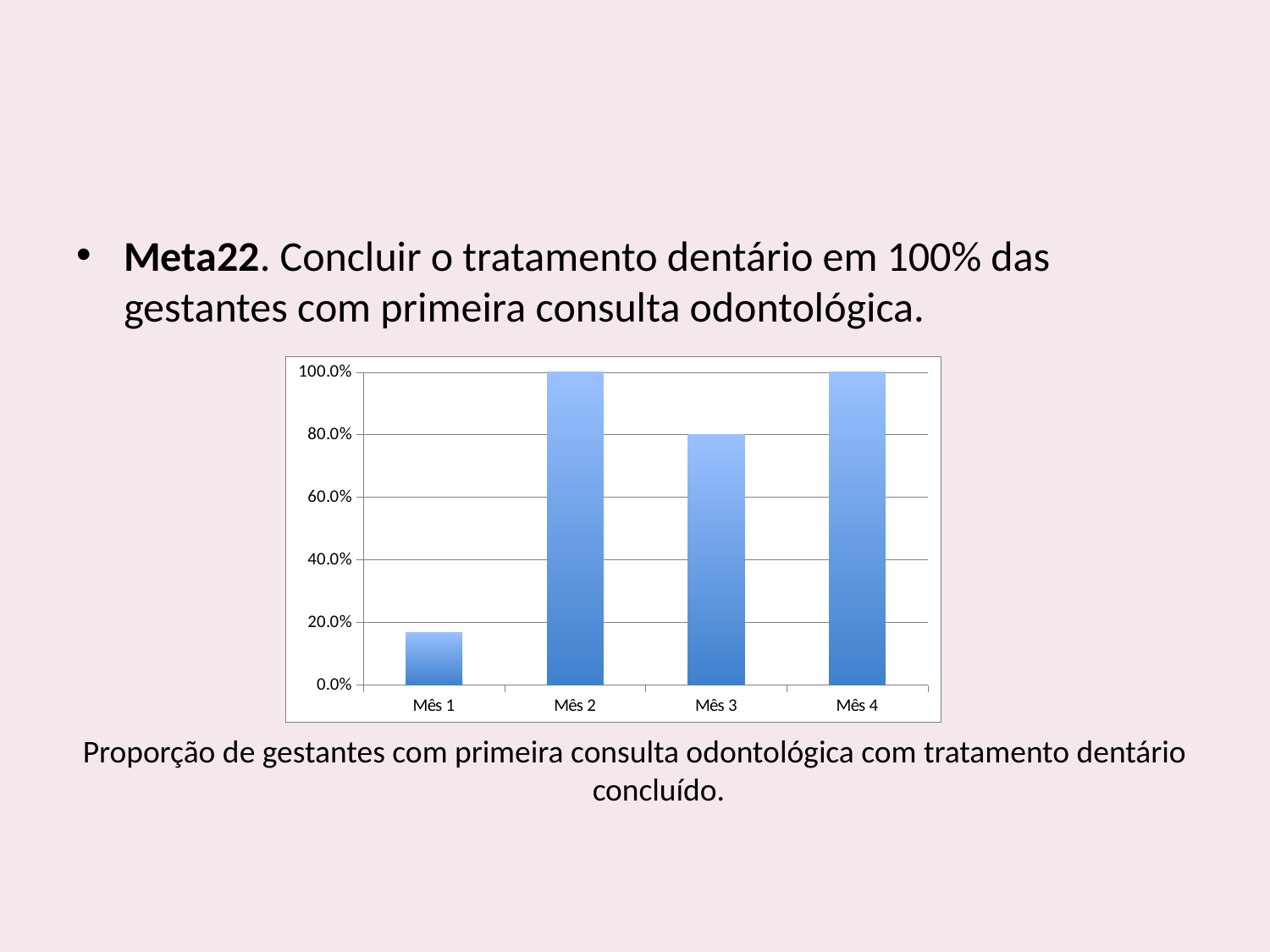
Does the value rise or fall from Mês 1 to Mês 2? Rise What is the value for Mês 2 in the chart? 100.0% What is the value for Mês 3 in the chart? 80.0% Is the value for Mês 1 greater or less than 20.0%? less Which month has the lowest value in the chart? Mês 1 How many categories (months) are shown on the x axis of the chart? 4 What kind of chart is shown on the slide? Bar chart What is the value for Mês 4 in the chart? 100.0% Which is larger, the value for Mês 1 or the value for Mês 3? Mês 3 What is the difference between the values for Mês 2 and Mês 3? 20.0% Is the value for Mês 3 greater or less than 60.0%? greater What is the caption given below the chart? Proporção de gestantes com primeira consulta odontológica com tratamento dentário concluído.